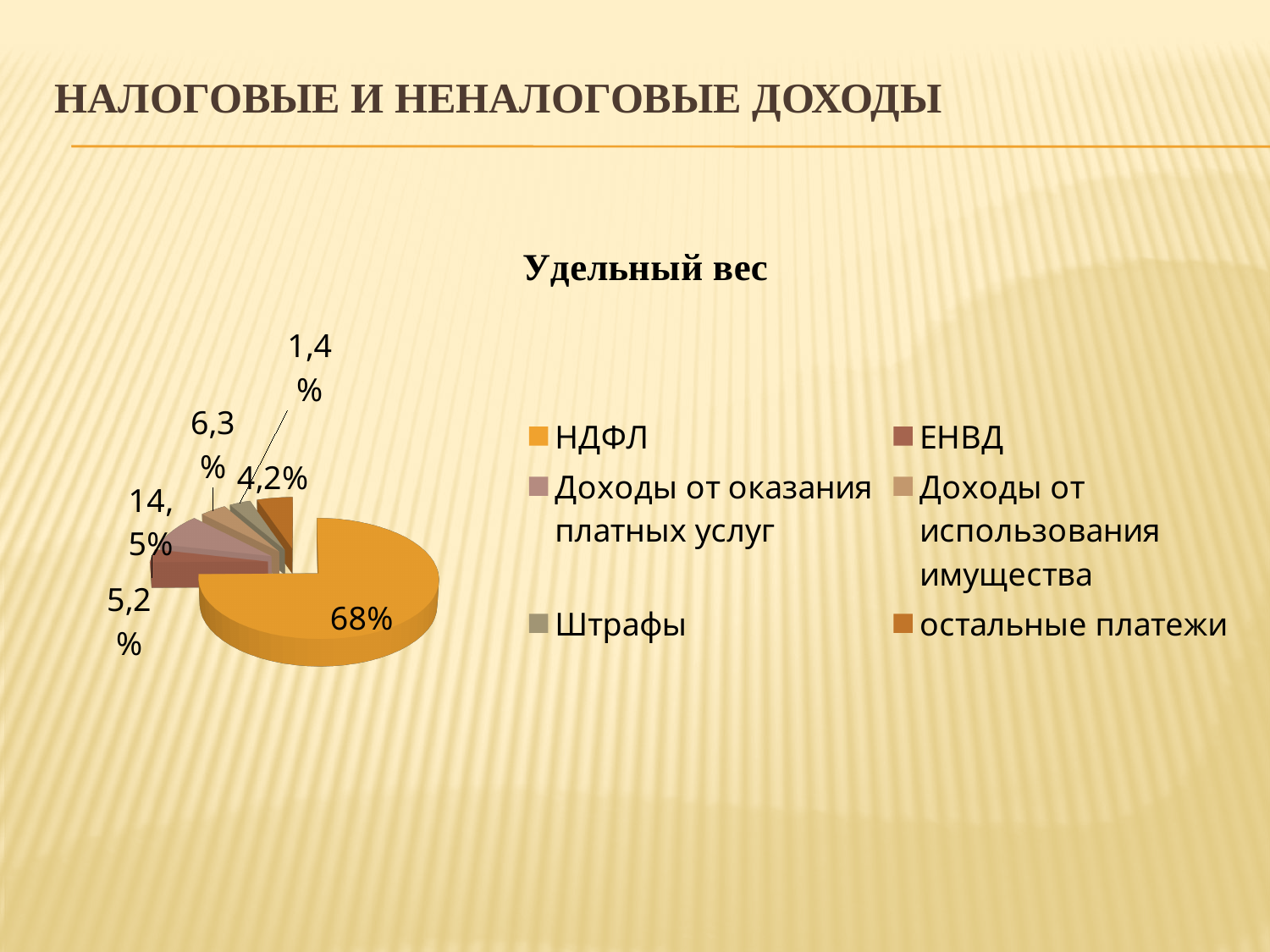
Which is larger, the share for ЕНВД or the share for Доходы от оказания платных услуг? Доходы от оказания платных услуг What kind of chart is shown on the slide? pie chart What share of the pie does остальные платежи have? 1,4% What share of the pie does Доходы от использования имущества have? 6,3% What share of the pie does НДФЛ have? 68% Which category has the largest slice of the pie? НДФЛ How many categories does the legend of the pie chart list? 6 What share of the pie does Доходы от оказания платных услуг have? 14,5% What is the title of the chart? Удельный вес What share of the pie does ЕНВД have? 5,2% What share of the pie does Штрафы have? 4,2%